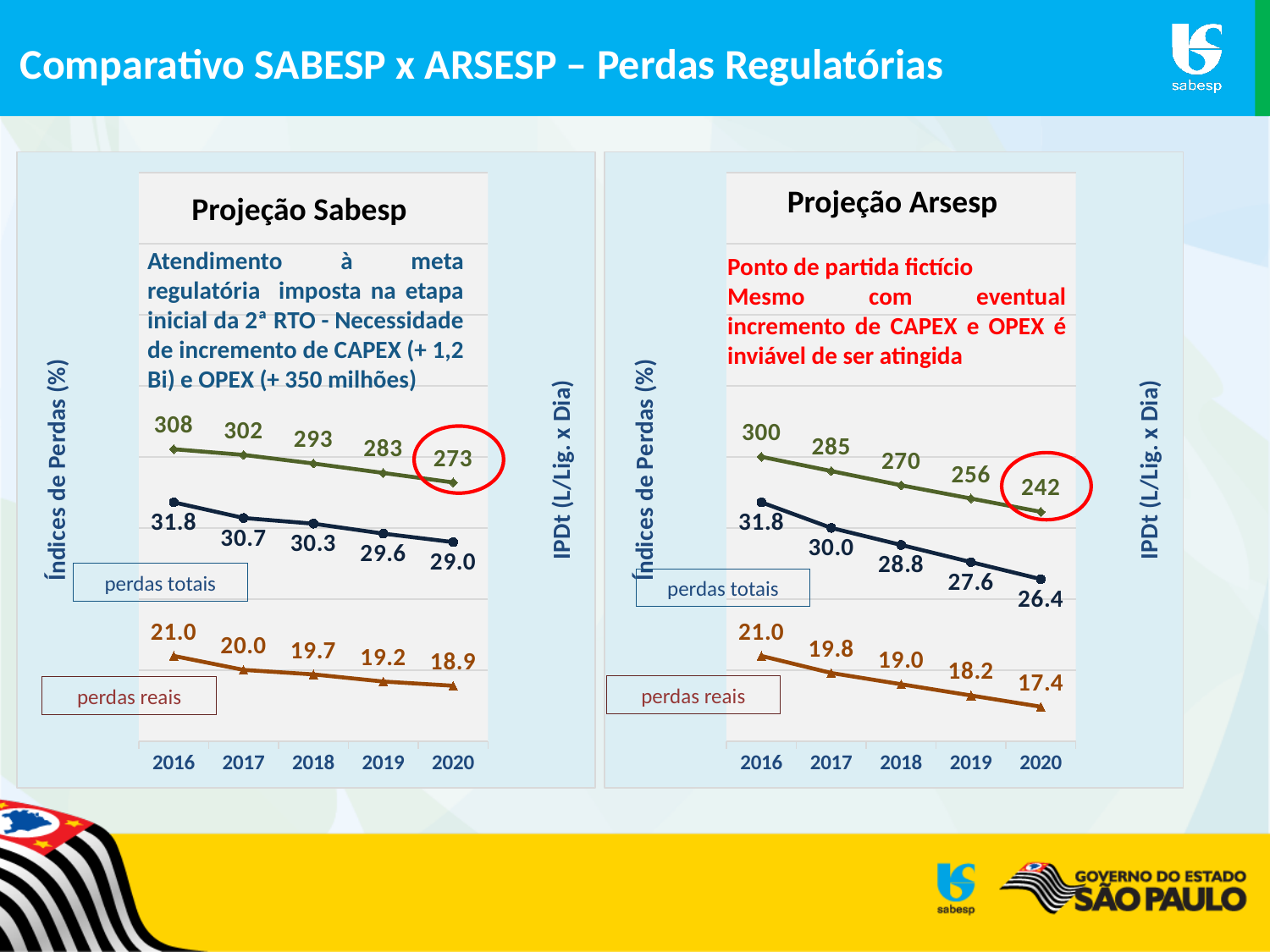
How many years are shown on the x axis of the 'Projeção Arsesp' chart? 5 In the 'Projeção Arsesp' chart, do the 'perdas totais' values rise or fall from 2016 to 2020? Fall In the 'Projeção Sabesp' chart, which year has the highest IPDt value? 2016 Which is larger: the 2020 IPDt value in the 'Projeção Sabesp' chart or in the 'Projeção Arsesp' chart? Projeção Sabesp In the 'Projeção Sabesp' chart, what is the difference between the IPDt values for 2016 and 2020? 35 In the 'Projeção Sabesp' chart, what is the 'perdas totais' value for 2018? 30.3 In the 'Projeção Arsesp' chart, which year has the lowest 'perdas totais' value? 2020 What type of chart is 'Projeção Sabesp'? Line chart In the 'Projeção Arsesp' chart, what is the difference between the 'perdas reais' values for 2016 and 2020? 3.6 In the 'Projeção Arsesp' chart, what is the IPDt value for 2020? 242 In the 'Projeção Arsesp' chart, what is the 'perdas reais' value for 2019? 18.2 In the 'Projeção Sabesp' chart, what is the IPDt value for 2020? 273